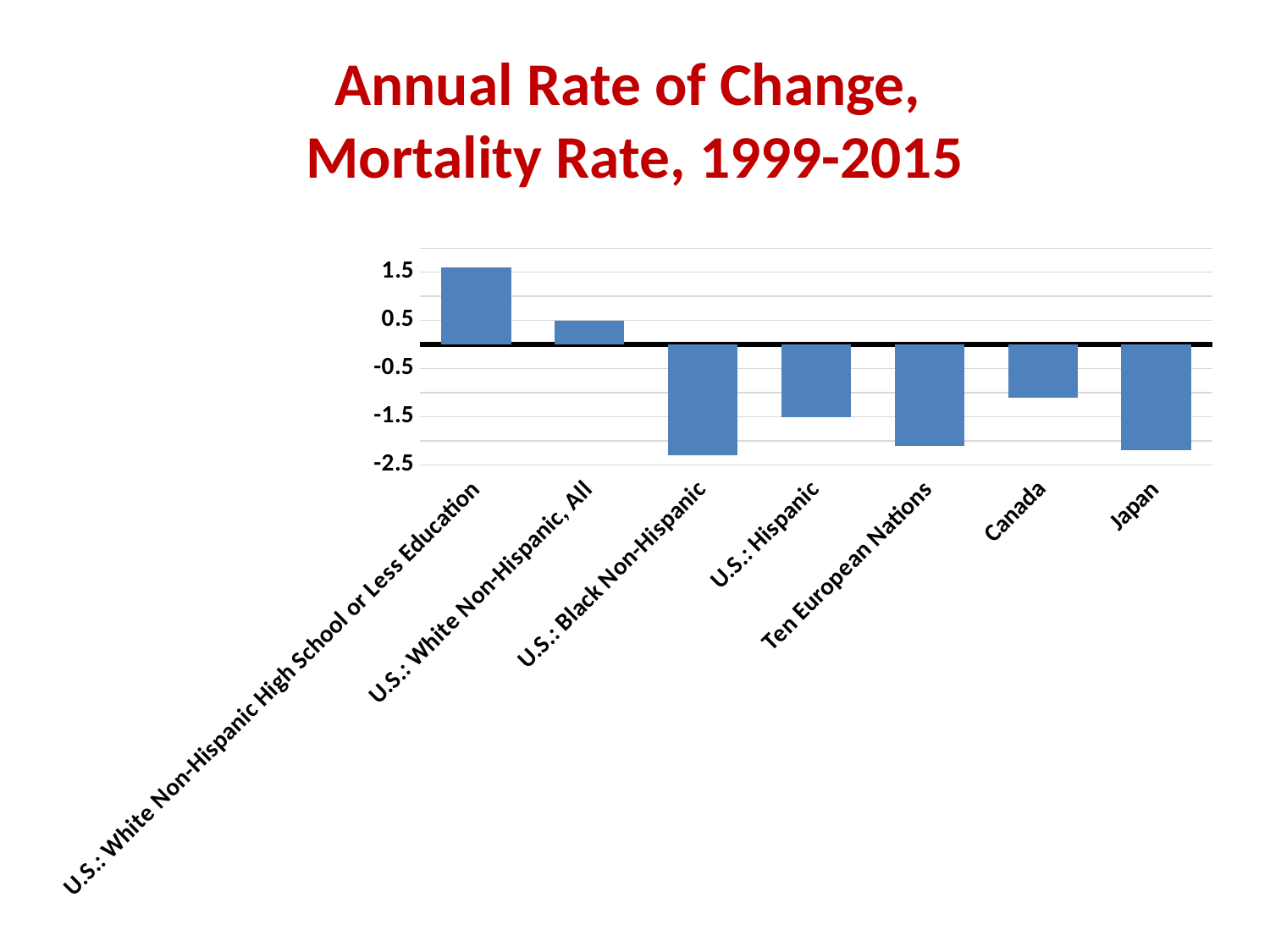
Is the value for U.S.: White Non-Hispanic High School or Less Education greater or less than 0.5? greater How many categories are plotted in the chart? 7 Which has the larger value, Canada or Japan? Canada Is the value for Japan greater or less than -1.5? less Which has the larger value, U.S.: White Non-Hispanic, All or U.S.: Hispanic? U.S.: White Non-Hispanic, All Is the value for U.S.: Black Non-Hispanic greater or less than -1.5? less What kind of chart is shown on the slide? Bar chart What is the title of the chart? Annual Rate of Change, Mortality Rate, 1999-2015 Which category has the highest annual rate of change? U.S.: White Non-Hispanic High School or Less Education